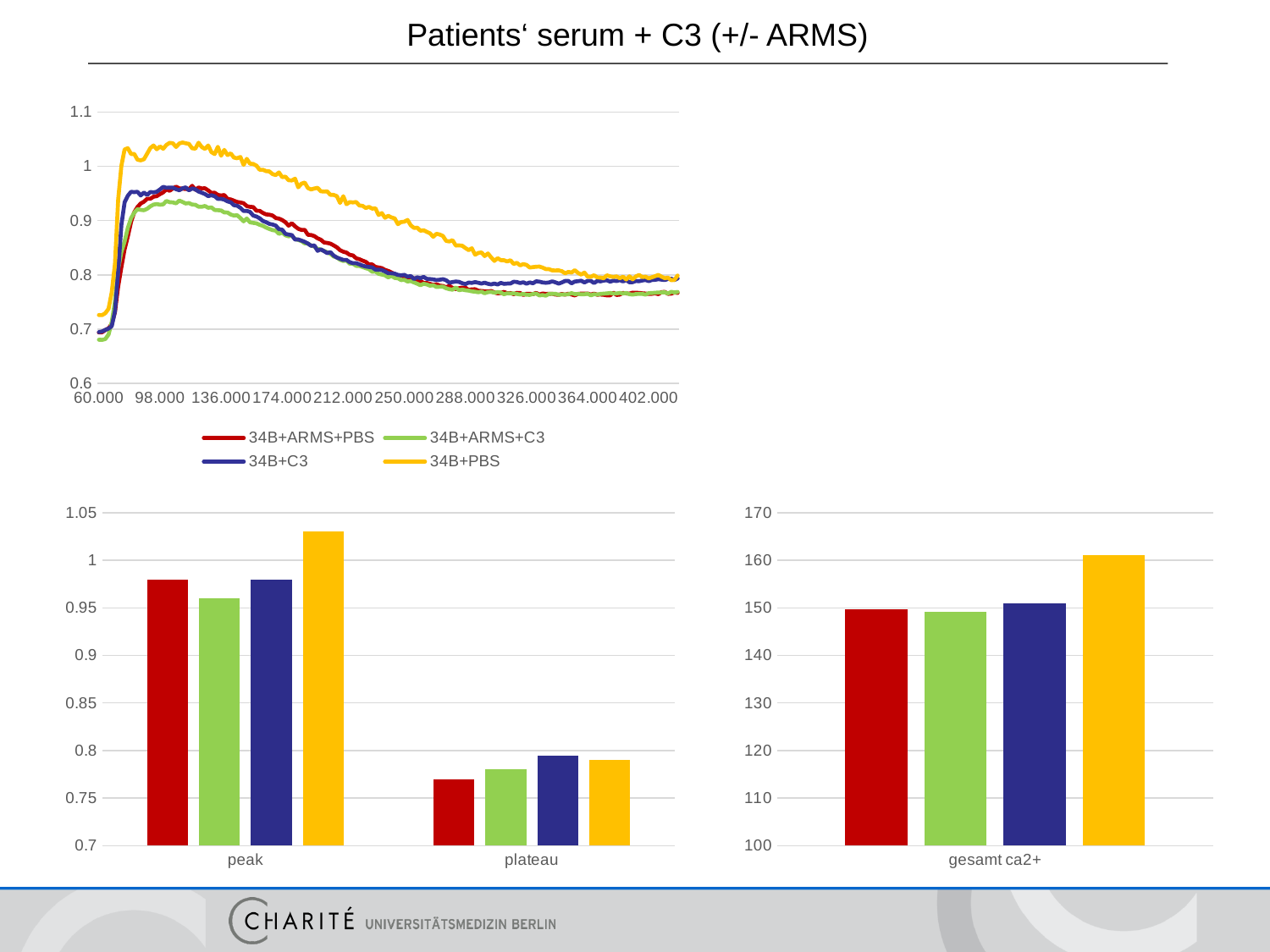
In the top-left line chart, do the values rise or fall along the x axis after about 136.000? fall What kind of chart is the top-left chart on the slide? line chart What kind of chart is the bottom-left chart with the categories peak and plateau? bar chart In the bottom-left bar chart, which category has the higher values, peak or plateau? peak How many categories are shown on the x axis of the bottom-left bar chart? 2 In the bottom-left bar chart, is the red bar for peak greater or less than 1? less In the bottom-left bar chart, is the yellow bar for peak greater or less than 1? greater In the bottom-right bar chart (gesamt ca2+), which bar is the highest? the yellow bar How many series does the legend of the top-left line chart list? 4 In the bottom-right bar chart (gesamt ca2+), is the yellow bar greater or less than 150? greater In the top-left line chart, which series reaches the highest values? 34B+PBS